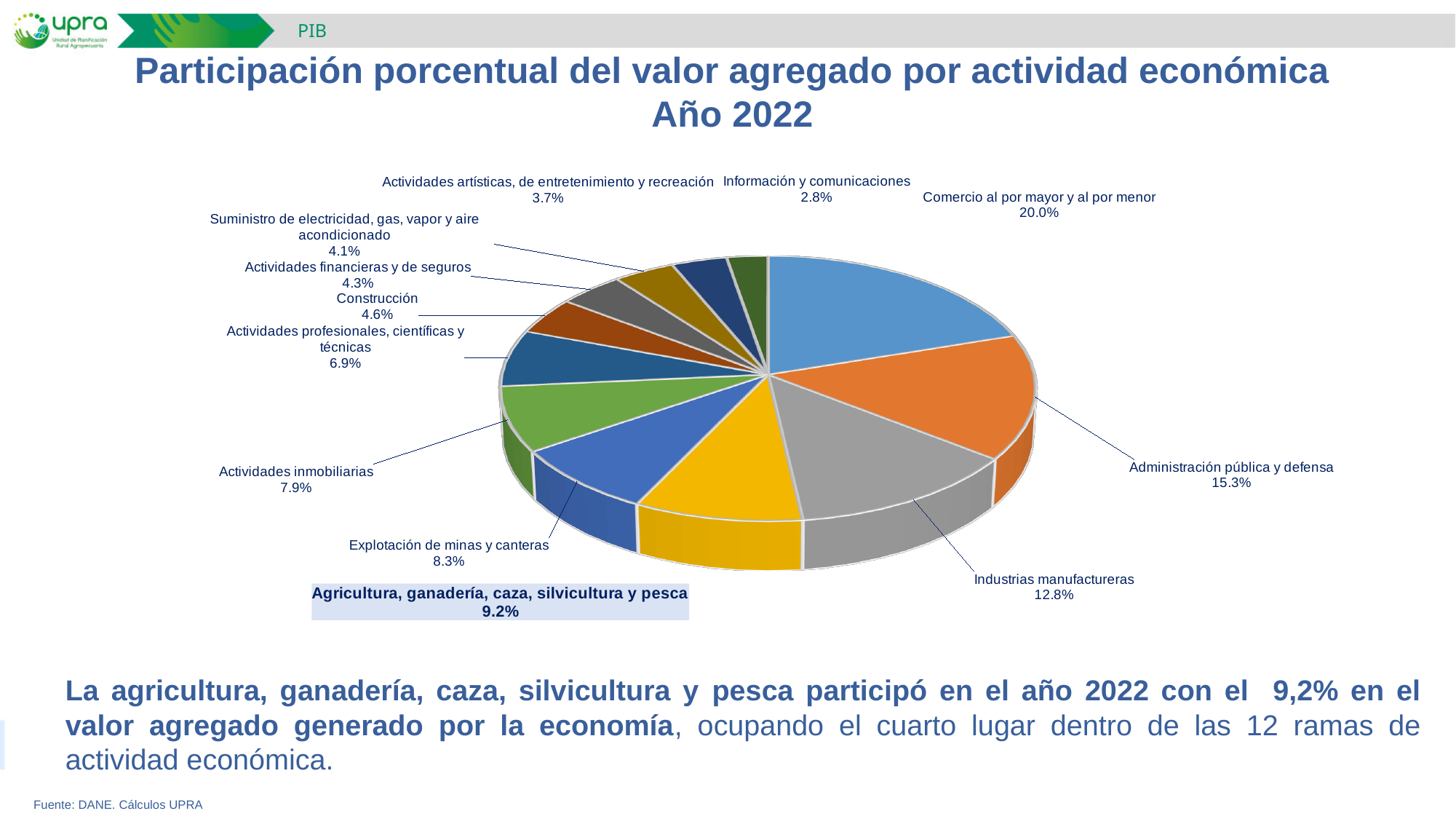
Which economic activity has the smallest share in the pie chart? Información y comunicaciones What percentage does Agricultura, ganadería, caza, silvicultura y pesca represent in the chart? 9.2% What is the value shown for Industrias manufactureras? 12.8% What year does the chart title refer to? 2022 Which economic activity has the largest share in the pie chart? Comercio al por mayor y al por menor What type of chart is shown on the slide? Pie chart Which is larger: Explotación de minas y canteras or Actividades inmobiliarias? Explotación de minas y canteras What is the difference in percentage points between Comercio al por mayor y al por menor and Administración pública y defensa? 4.7 What is the difference in percentage points between Agricultura, ganadería, caza, silvicultura y pesca and Construcción? 4.6 What is the value shown for Información y comunicaciones? 2.8% How many slices (economic activities) does the pie chart contain? 12 What is the share of Comercio al por mayor y al por menor in the pie chart? 20.0%